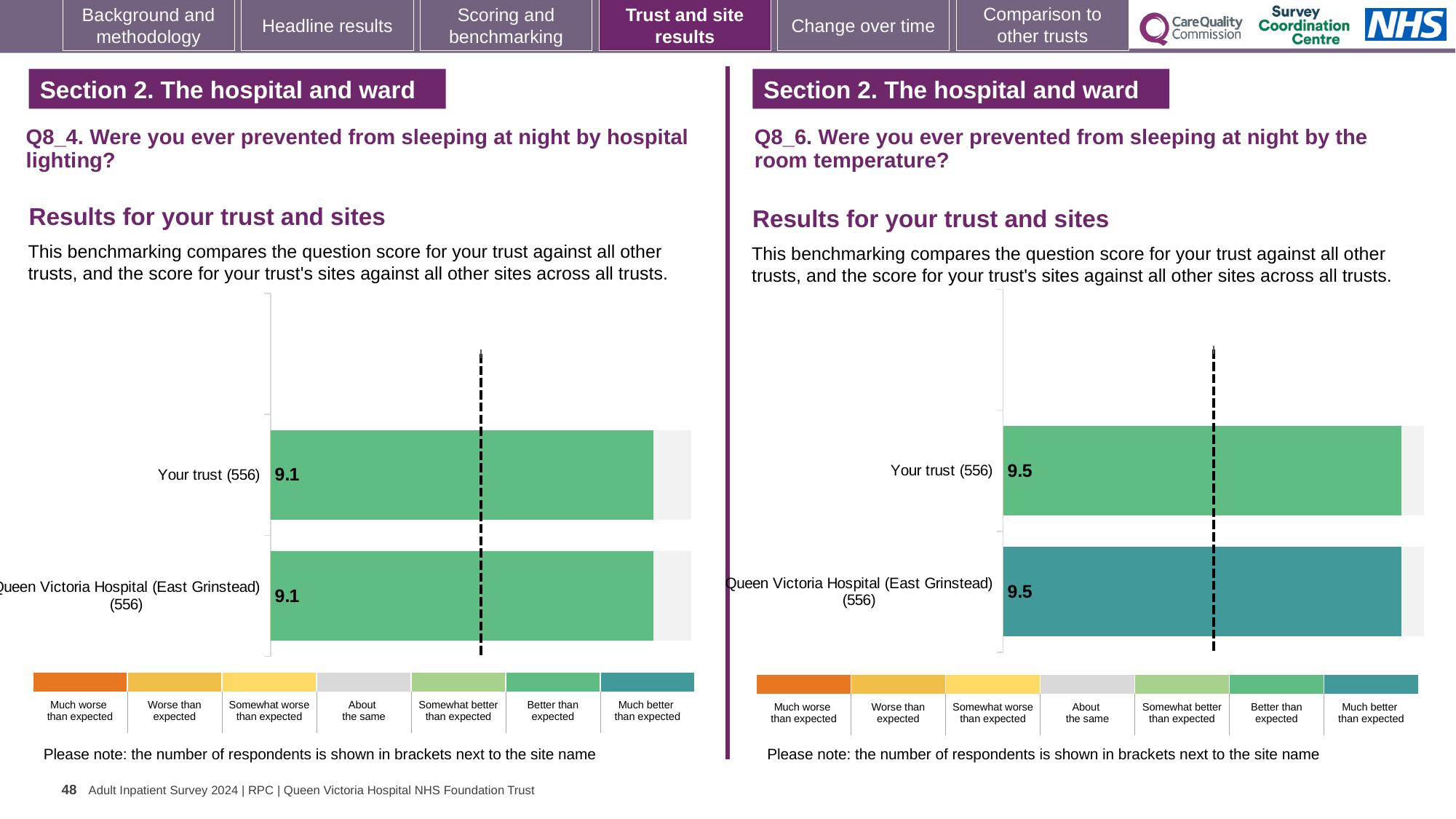
On the Q8_6 chart (room temperature), what is the score for Queen Victoria Hospital (East Grinstead) (556)? 9.5 On the Q8_6 chart (room temperature), what is the score for Your trust (556)? 9.5 On the Q8_4 chart (hospital lighting), what is the score for Queen Victoria Hospital (East Grinstead) (556)? 9.1 On the Q8_4 chart (hospital lighting), what is the score for Your trust (556)? 9.1 What kind of chart is used on the Q8_6 chart (room temperature)? Bar chart On the Q8_6 chart (room temperature), which benchmark category does the colour of the Queen Victoria Hospital (East Grinstead) bar indicate? Much better than expected How many bars are plotted on the Q8_6 chart (room temperature)? 2 On the Q8_4 chart (hospital lighting), which benchmark category does the colour of the Your trust bar indicate? Better than expected How many bars are plotted on the Q8_4 chart (hospital lighting)? 2 On the Q8_4 chart (hospital lighting), what is the difference between the score for Your trust and the score for Queen Victoria Hospital (East Grinstead)? 0.0 On the Q8_6 chart (room temperature), what is the difference between the score for Your trust and the score for Queen Victoria Hospital (East Grinstead)? 0.0 How many respondents are shown in brackets for Your trust on the Q8_4 chart (hospital lighting)? 556